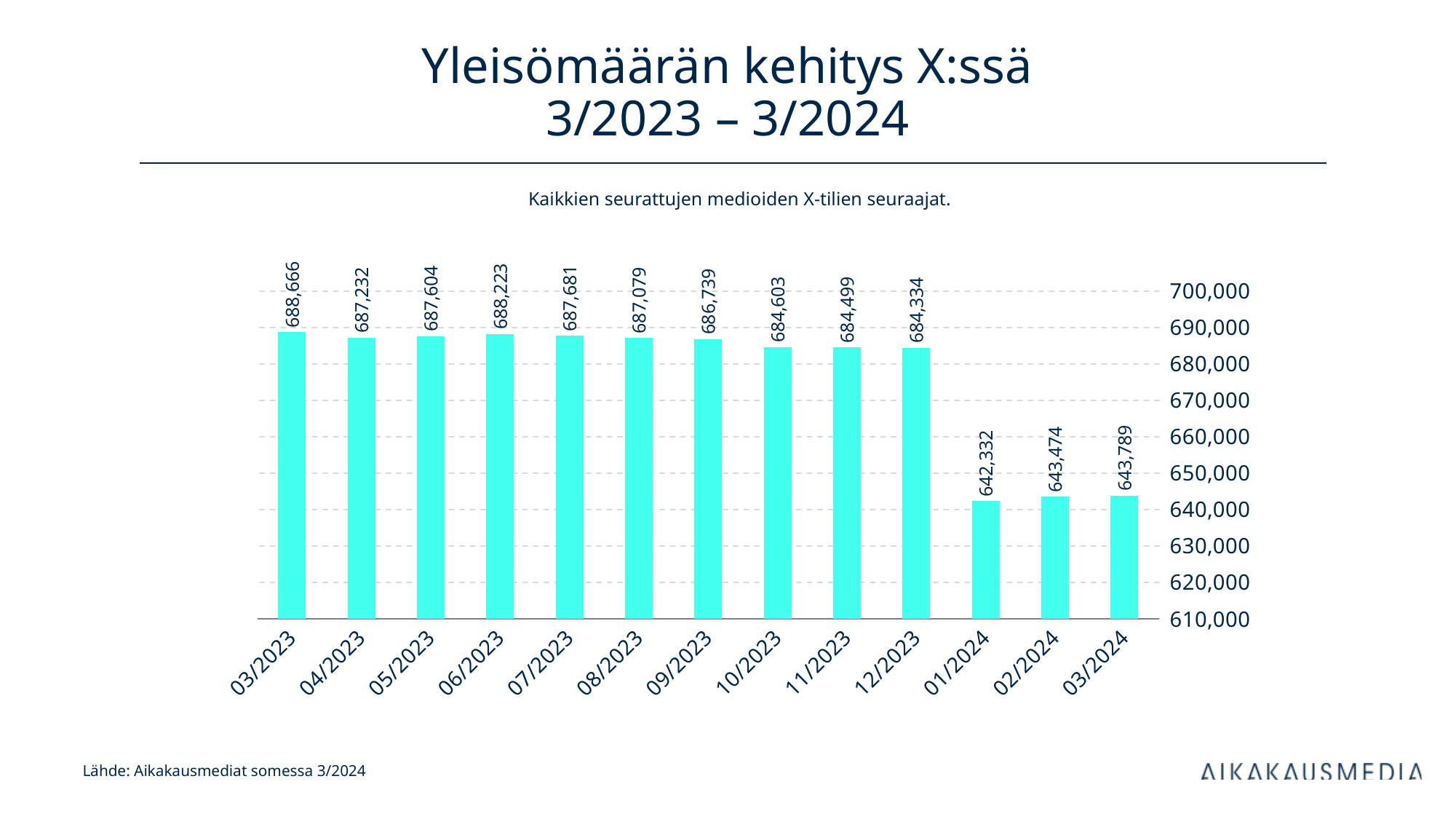
Is the value for 02/2024 greater or less than 650,000? less What is the value for 03/2023? 688,666 Do the values overall rise or fall from 03/2023 to 03/2024? fall Which month has the lowest value? 01/2024 What kind of chart is shown on the slide? bar chart What is the difference between the values for 12/2023 and 01/2024? 42,002 What is the difference between the values for 03/2023 and 03/2024? 44,877 What is the value for 09/2023? 686,739 What is the value for 01/2024? 642,332 Which month has the highest value? 03/2023 Which is larger, the value for 06/2023 or the value for 05/2023? 06/2023 How many months are shown on the x axis? 13